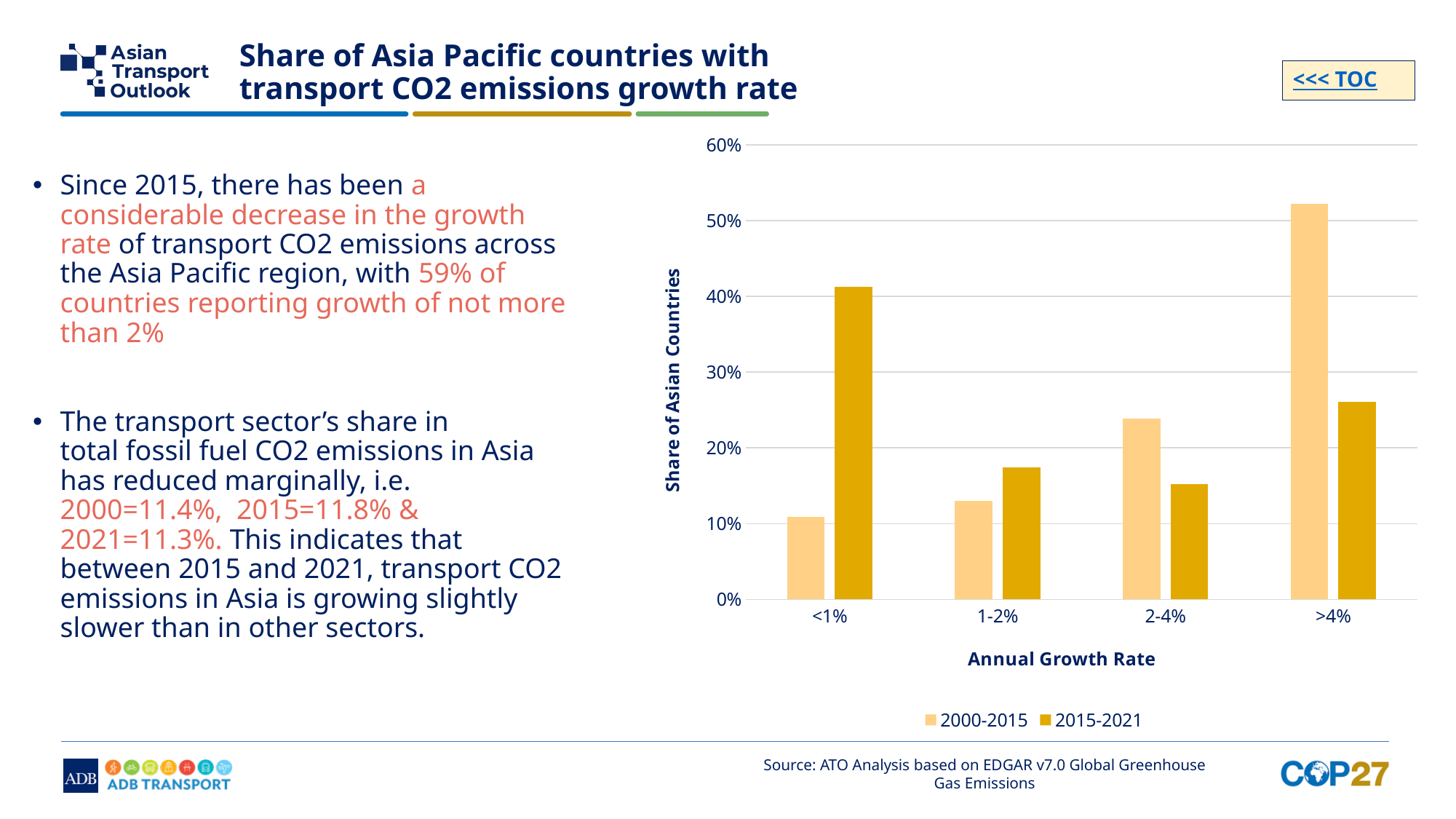
How many series does the legend list? 2 Which annual growth rate category has the highest share for the 2015-2021 series? <1% For the <1% category, which series has the larger value, 2000-2015 or 2015-2021? 2015-2021 Is the 2000-2015 value for the <1% category greater or less than 20%? less Which annual growth rate category has the lowest share for the 2000-2015 series? <1% Is the 2015-2021 value for the <1% category greater or less than 30%? greater Is the 2000-2015 value for the >4% category greater or less than 40%? greater Do the 2000-2015 values rise or fall as you move from <1% to >4% along the x axis? rise Which annual growth rate category has the highest share for the 2000-2015 series? >4% For the 2-4% category, which series has the larger value, 2000-2015 or 2015-2021? 2000-2015 What kind of chart is shown on the slide? bar chart How many annual growth rate categories are shown on the x axis? 4